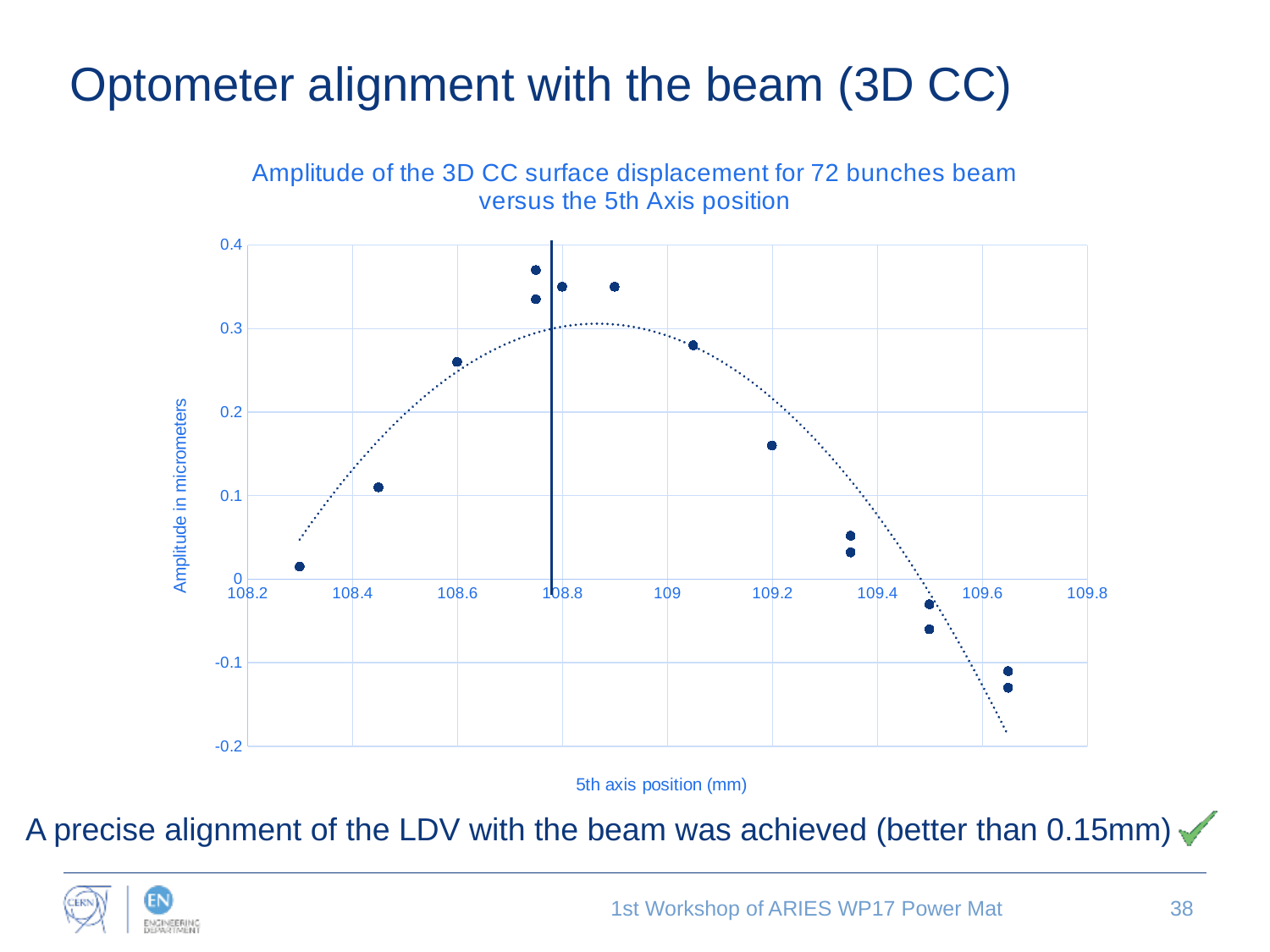
What is the label of the vertical axis? Amplitude in micrometers Is the amplitude at 5th axis position 109.2 mm greater or less than 0.2? less What is the title of the chart? Amplitude of the 3D CC surface displacement for 72 bunches beam versus the 5th Axis position Is the amplitude at 5th axis position 108.3 mm greater or less than 0.1? less Is the amplitude at 5th axis position 108.6 mm greater or less than 0.2? greater Which has the larger amplitude: the point at 108.6 mm or the point at 109.2 mm? 108.6 mm What kind of chart is shown on the slide? Scatter chart How does the amplitude change as the 5th axis position increases from 108.2 to 109.8 mm? It rises to a peak near 108.8 mm and then falls What is the lowest value shown on the vertical axis? -0.2